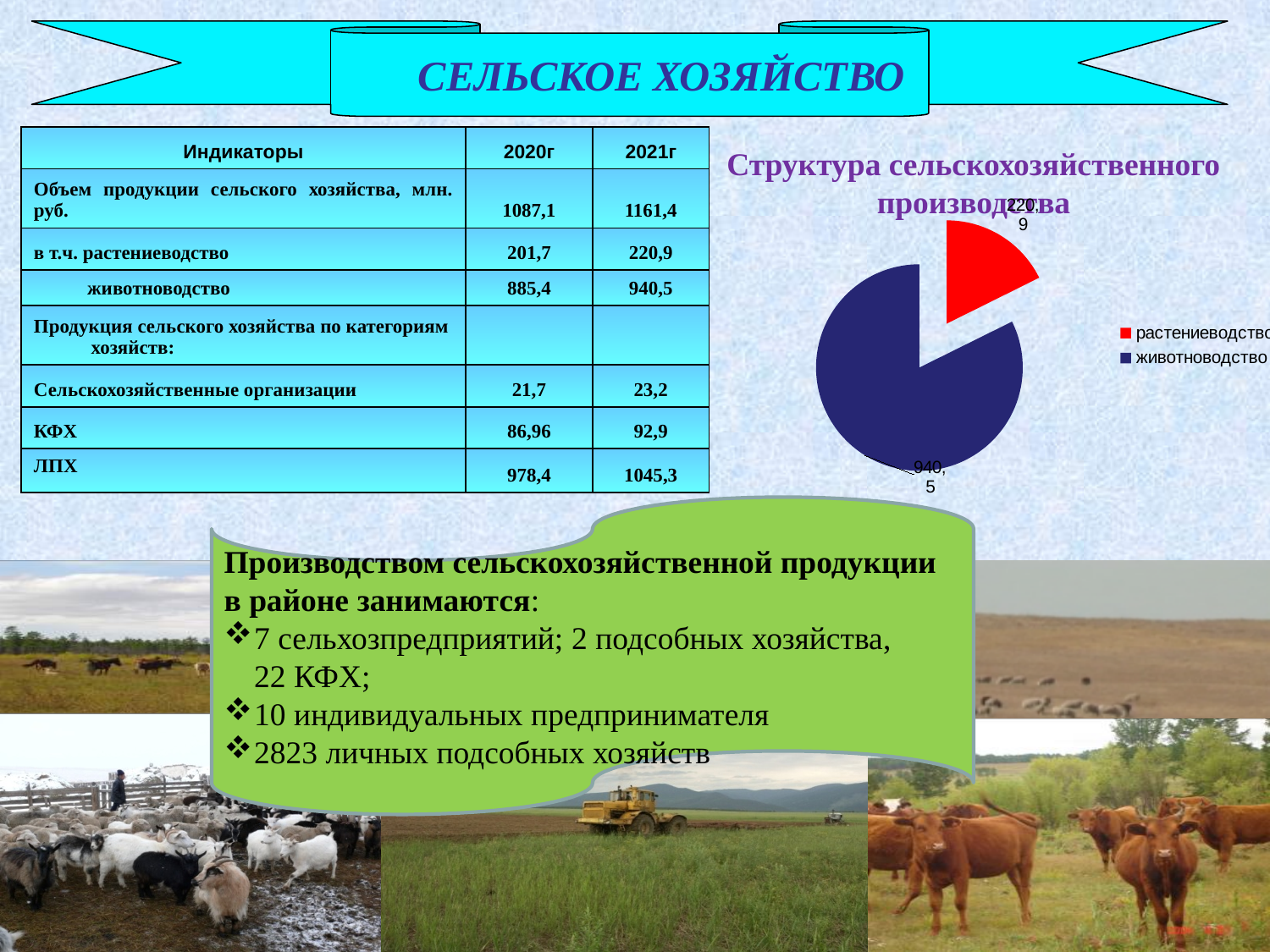
What value is shown for растениеводство in the pie chart? 220,9 What is the total of the two values shown in the pie chart? 1161,4 What colour is the растениеводство slice in the pie chart? red Which slice of the pie chart is the largest? животноводство Which slice of the pie chart is the smallest? растениеводство How many slices does the pie chart have? 2 What value is shown for животноводство in the pie chart? 940,5 What is the title of the pie chart? Структура сельскохозяйственного производства What is the difference between the животноводство and растениеводство values in the pie chart? 719,6 Which is larger in the pie chart, растениеводство or животноводство? животноводство What kind of chart is shown on the slide? pie chart How many entries does the legend of the pie chart list? 2